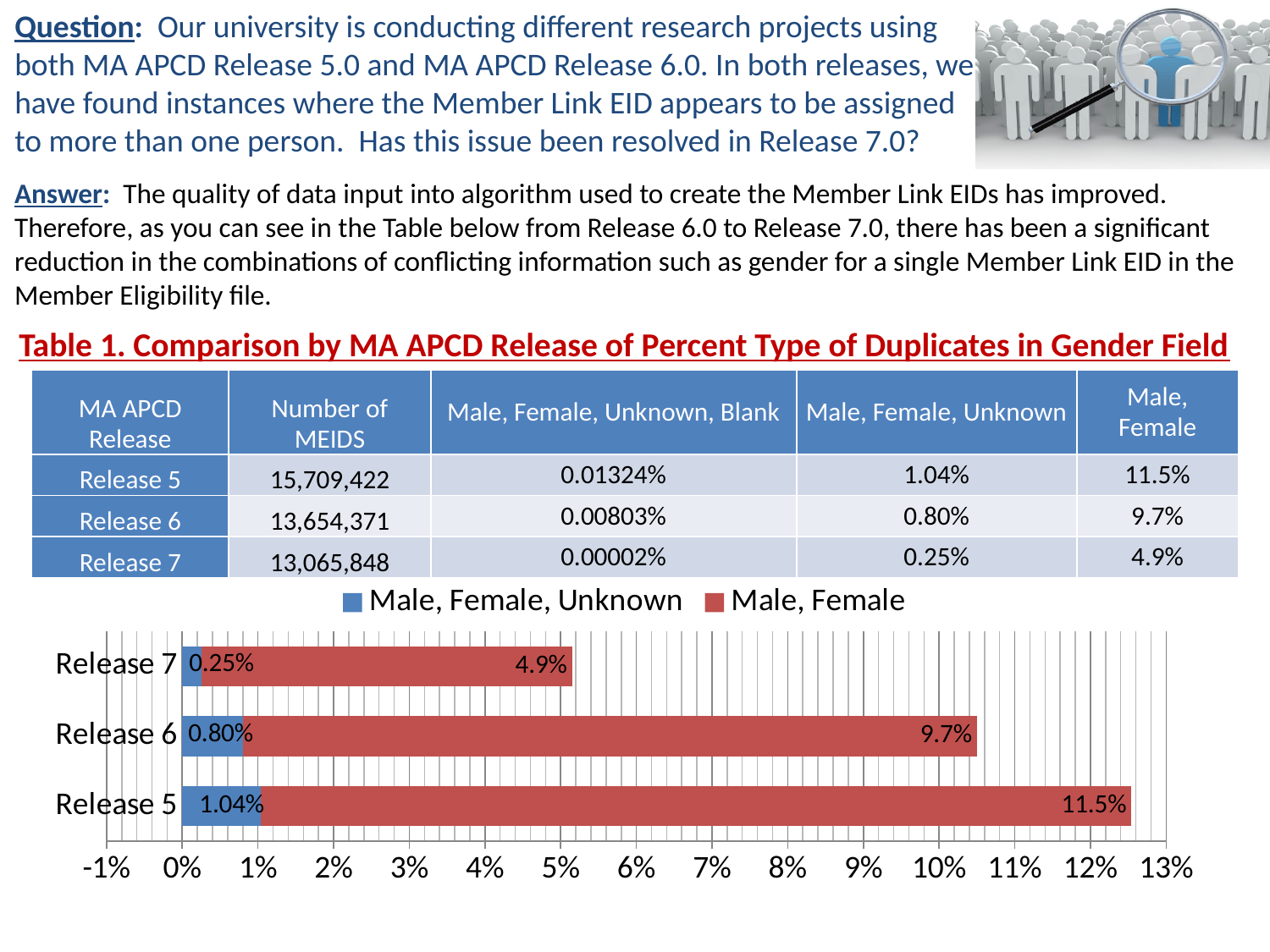
What kind of chart is shown on the slide? bar chart Which colour represents the Male, Female series in the chart? red Which is larger in the chart: the Male, Female value for Release 6 or for Release 7? Release 6 What is the total of the stacked bar for Release 6 in the chart? 10.5% How many series does the chart legend list? 2 In the chart, what is the value of the Male, Female, Unknown series for Release 7? 0.25% In the chart, what is the value of the Male, Female, Unknown series for Release 5? 1.04% Which release has the lowest Male, Female, Unknown value in the chart? Release 7 How many releases (categories) are plotted in the chart? 3 Which release has the highest Male, Female value in the chart? Release 5 In the chart, what is the value of the Male, Female series for Release 6? 9.7% What is the difference between the Male, Female values for Release 5 and Release 7 in the chart? 6.6%